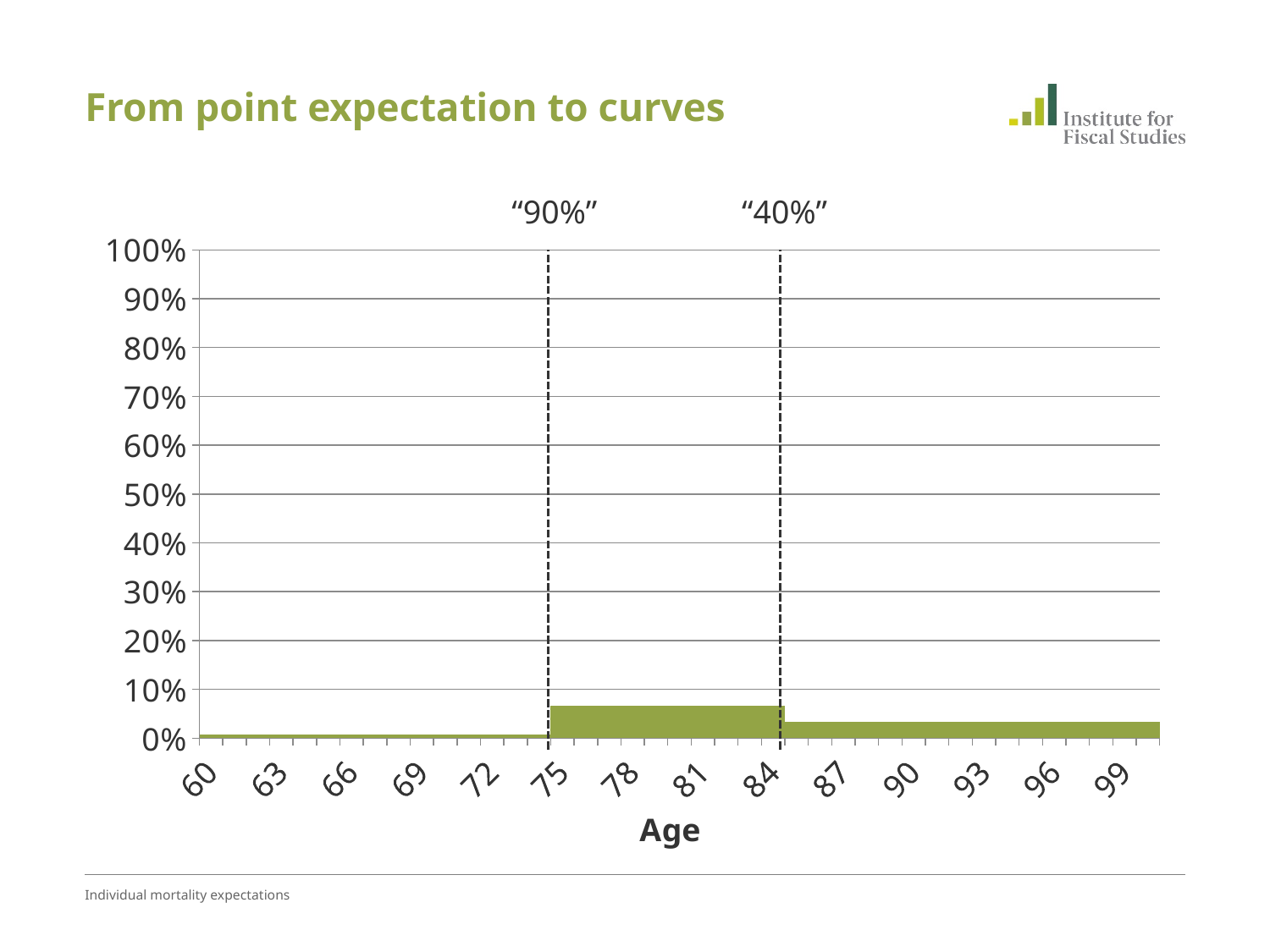
Which is larger, the value for age 78 or the value for age 90? age 78 What is the title of the slide's chart? From point expectation to curves Which is larger, the value for age 66 or the value for age 90? age 90 Is the value for age 78 greater or less than 10%? less What is the highest value shown on the y axis? 100% How many age labels are printed along the x axis? 14 What is the label on the x axis of the chart? Age Which is larger, the value for age 66 or the value for age 78? age 78 Is the value for age 66 greater or less than 10%? less What kind of chart is shown on the slide? bar chart Which age range has the tallest bars: 60 to 74, 75 to 84, or 85 to 99? 75 to 84 Is the value for age 90 greater or less than 10%? less